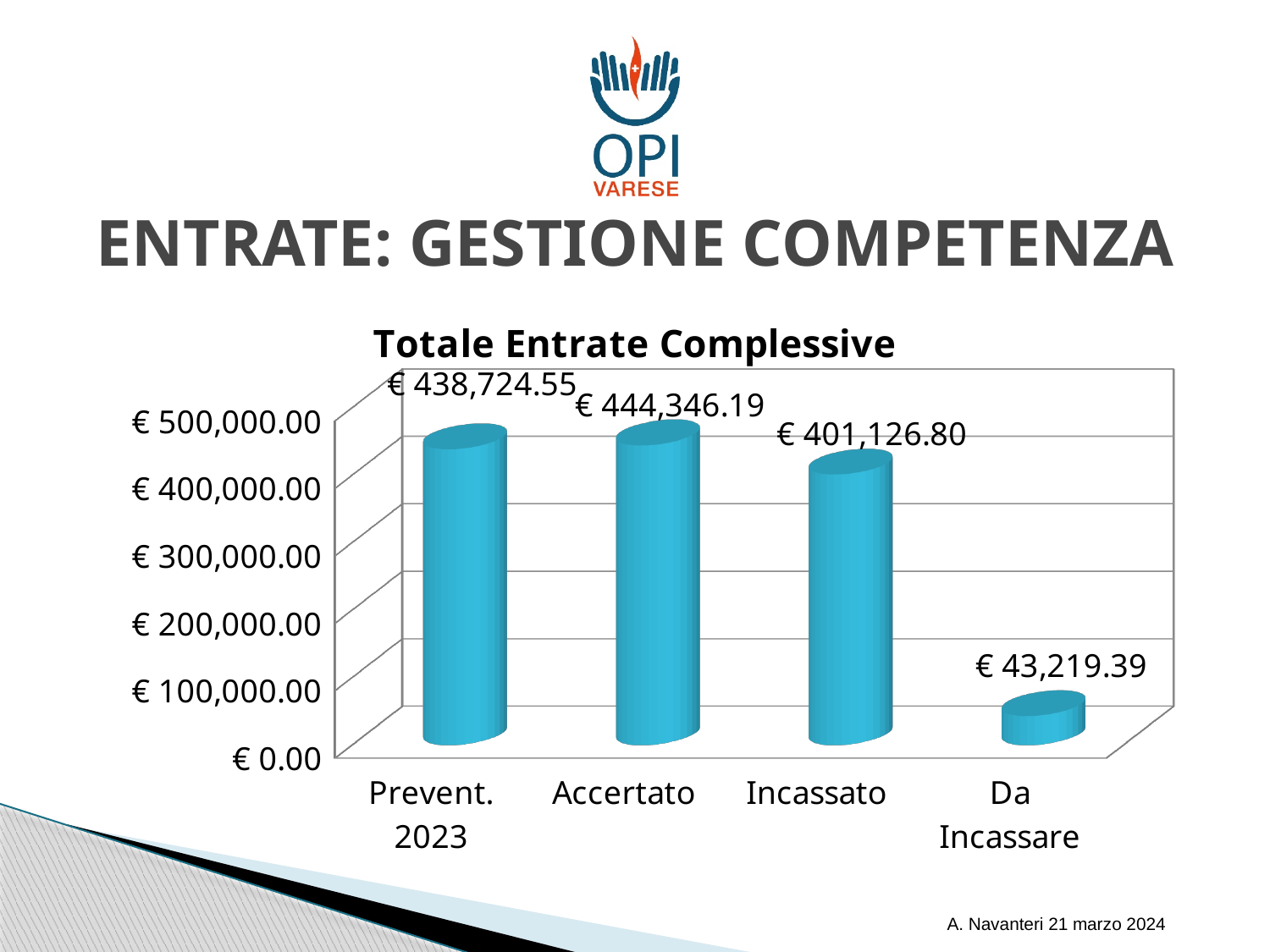
Which category has the lowest value in the chart? Da Incassare What is the value for Prevent. 2023 in the Totale Entrate Complessive chart? € 438,724.55 How many categories are shown on the x axis of the chart? 4 What is the value for Da Incassare? € 43,219.39 What is the value for Accertato in the Totale Entrate Complessive chart? € 444,346.19 What is the difference between Accertato and Incassato? € 43,219.39 Which category has the highest value in the chart? Accertato What is the value for Incassato? € 401,126.80 Is the value for Da Incassare greater or less than € 100,000.00? less What type of chart is shown on the slide? Bar chart Which is larger, the value for Incassato or the value for Da Incassare? Incassato What is the difference between Accertato and Prevent. 2023? € 5,621.64